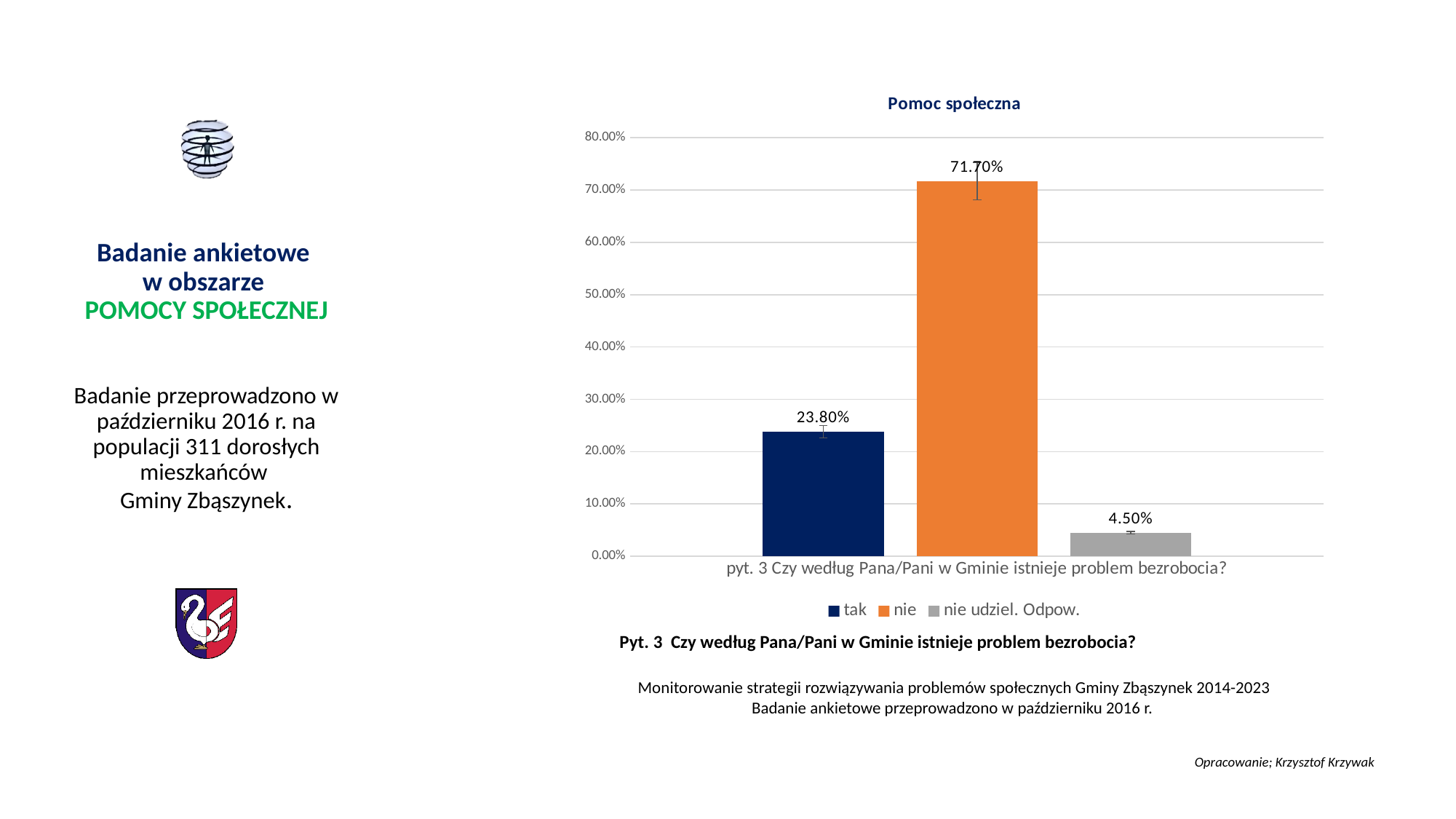
What colour is the bar for "nie"? orange What kind of chart is shown on the slide? bar chart Is the value for "nie" greater or less than 70.00%? greater What is the difference between the values for "nie" and "tak"? 47.90% How many series does the legend list? 3 Which is larger, the value for "tak" or the value for "nie udziel. Odpow."? tak What is the value for "nie udziel. Odpow." in the chart? 4.50% What is the title of the chart? Pomoc społeczna What is the value for "tak" in the chart? 23.80% What is the value for "nie" in the chart? 71.70% Which series has the highest value in the chart? nie Which series has the lowest value in the chart? nie udziel. Odpow.